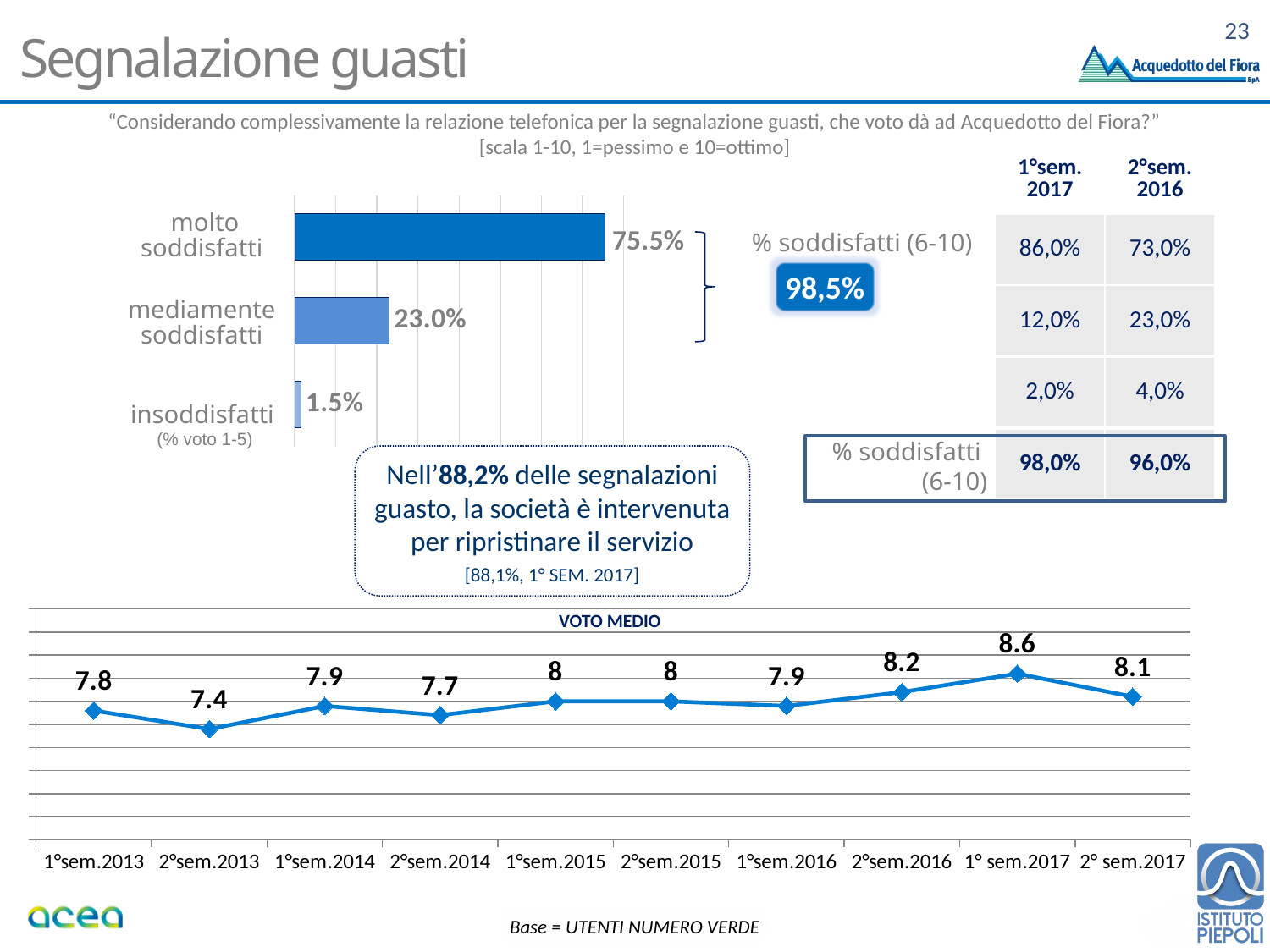
In the "VOTO MEDIO" chart, what is the difference between the values for 1° sem.2017 and 2° sem.2017? 0.5 In the "VOTO MEDIO" chart, what is the value for 2°sem.2013? 7.4 In the bar chart at the top of the slide, what is the value for "molto soddisfatti"? 75.5% In the bar chart at the top of the slide, how many categories are shown? 3 In the bar chart at the top of the slide, what is the difference between "molto soddisfatti" and "mediamente soddisfatti"? 52.5% In the bar chart at the top of the slide, which category has the lowest value? insoddisfatti In the "VOTO MEDIO" chart, what is the value for 1° sem.2017? 8.6 In the bar chart at the top of the slide, what is the value for "mediamente soddisfatti"? 23.0% In the "VOTO MEDIO" chart, how many data points are plotted? 10 In the bar chart at the top of the slide, what is the value for "insoddisfatti"? 1.5% What kind of chart is the "VOTO MEDIO" chart at the bottom of the slide? line chart In the "VOTO MEDIO" chart, which period has the highest value? 1° sem.2017